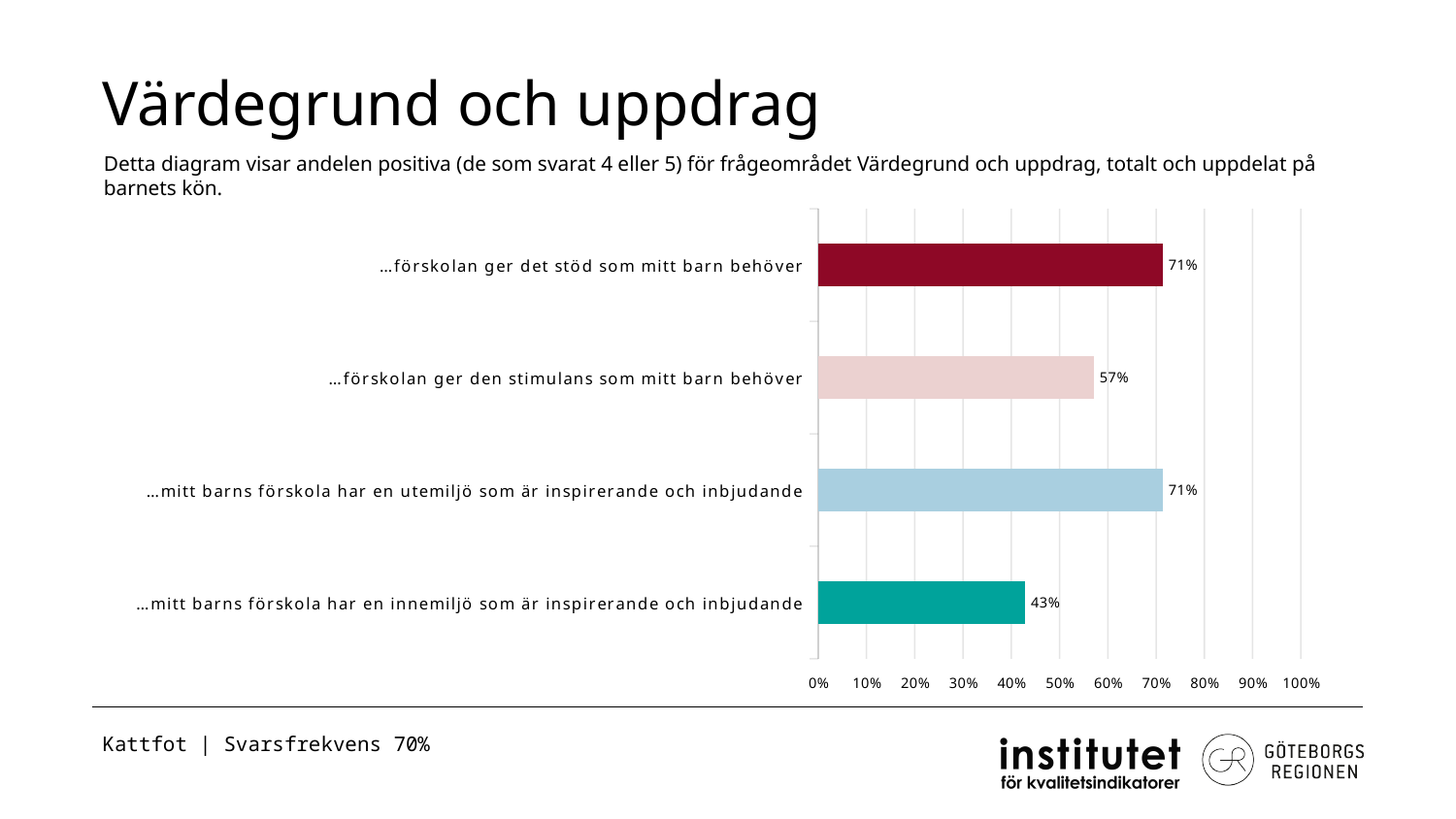
What is the difference between the values for "…förskolan ger det stöd som mitt barn behöver" and "…förskolan ger den stimulans som mitt barn behöver"? 14% What is the value for "…mitt barns förskola har en innemiljö som är inspirerande och inbjudande"? 43% What is the maximum value shown on the x axis? 100% What is the difference between the values for "…mitt barns förskola har en utemiljö som är inspirerande och inbjudande" and "…mitt barns förskola har en innemiljö som är inspirerande och inbjudande"? 28% What is the value for "…förskolan ger den stimulans som mitt barn behöver"? 57% How many categories are shown in the chart? 4 Which is larger: the value for "…förskolan ger den stimulans som mitt barn behöver" or the value for "…mitt barns förskola har en innemiljö som är inspirerande och inbjudande"? …förskolan ger den stimulans som mitt barn behöver Which category has the lowest value? …mitt barns förskola har en innemiljö som är inspirerande och inbjudande What kind of chart is shown on the slide? Bar chart Is the value for "…förskolan ger den stimulans som mitt barn behöver" greater or less than 50%? greater What is the value for "…mitt barns förskola har en utemiljö som är inspirerande och inbjudande"? 71% What is the value for "…förskolan ger det stöd som mitt barn behöver"? 71%